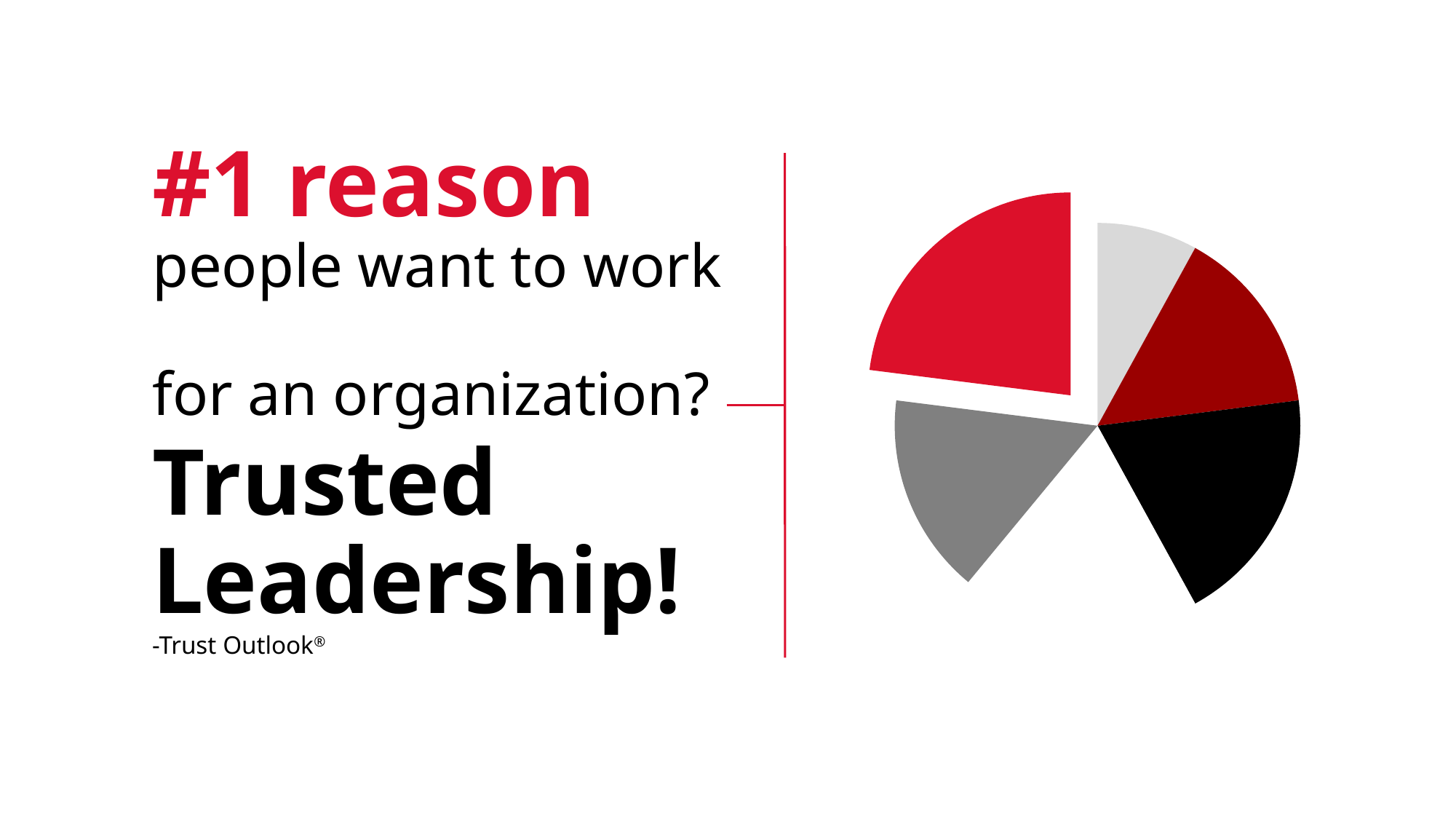
Which slice of the pie chart is the smallest? the light gray slice Is the light gray slice or the dark red slice of the pie chart larger? the dark red slice Does the pie chart display a legend? No Which slice of the pie chart is pulled out (exploded) from the rest of the pie? the red slice What kind of chart is shown on the right side of the slide? pie chart Is the light gray slice or the black slice of the pie chart larger? the black slice